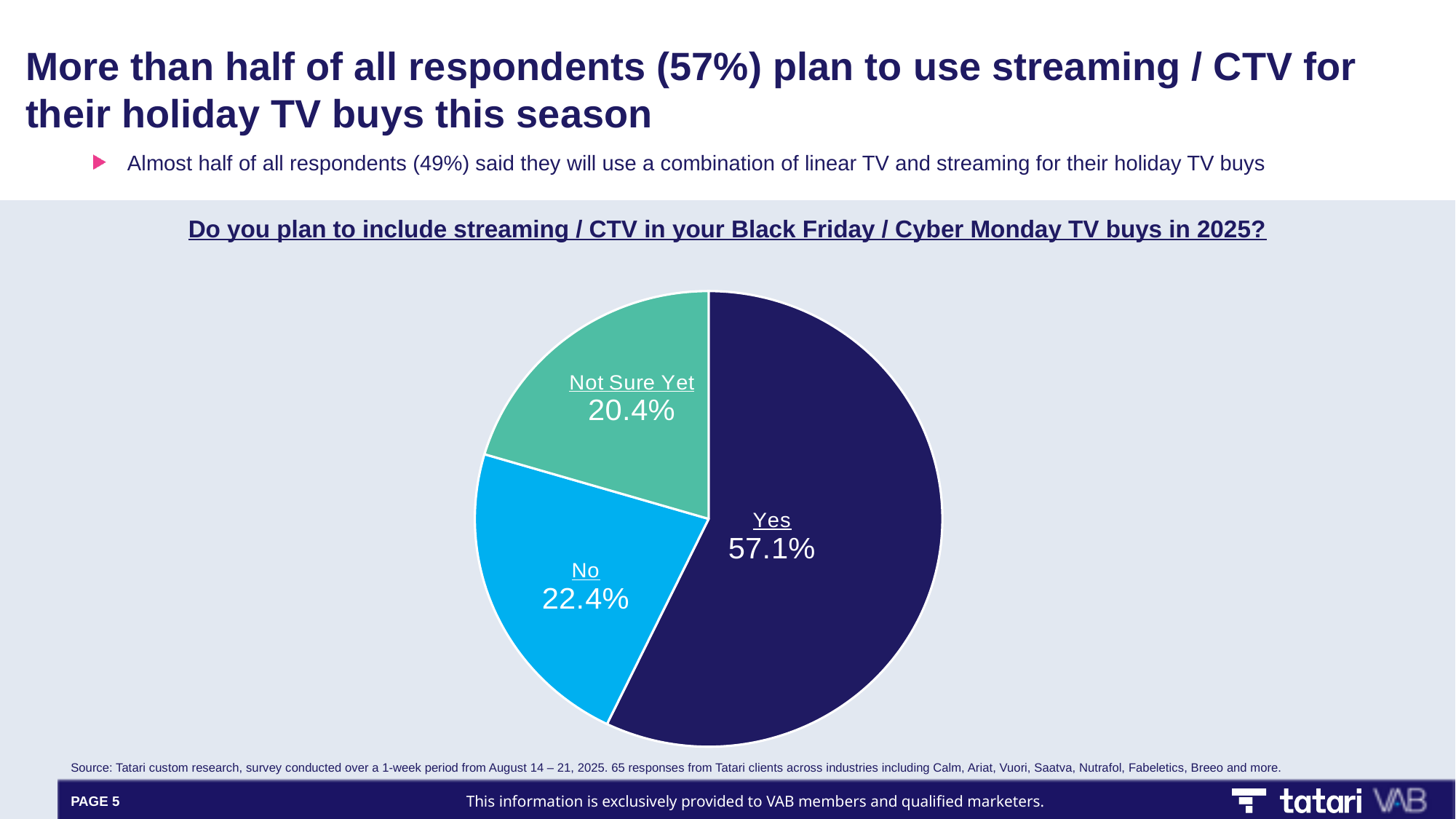
What percentage of respondents answered "No"? 22.4% What is the combined share of "No" and "Not Sure Yet"? 42.8% What is the difference in percentage points between "Yes" and "No"? 34.7 Which response has the largest share of the pie? Yes What percentage of respondents answered "Not Sure Yet"? 20.4% What kind of chart is shown on the slide? Pie chart What percentage of respondents answered "Yes"? 57.1% What is the difference in percentage points between "No" and "Not Sure Yet"? 2.0 Which is larger, the share for "No" or the share for "Not Sure Yet"? No Which response has the smallest share of the pie? Not Sure Yet What question does the chart title ask? Do you plan to include streaming / CTV in your Black Friday / Cyber Monday TV buys in 2025? How many slices does the pie chart have? 3